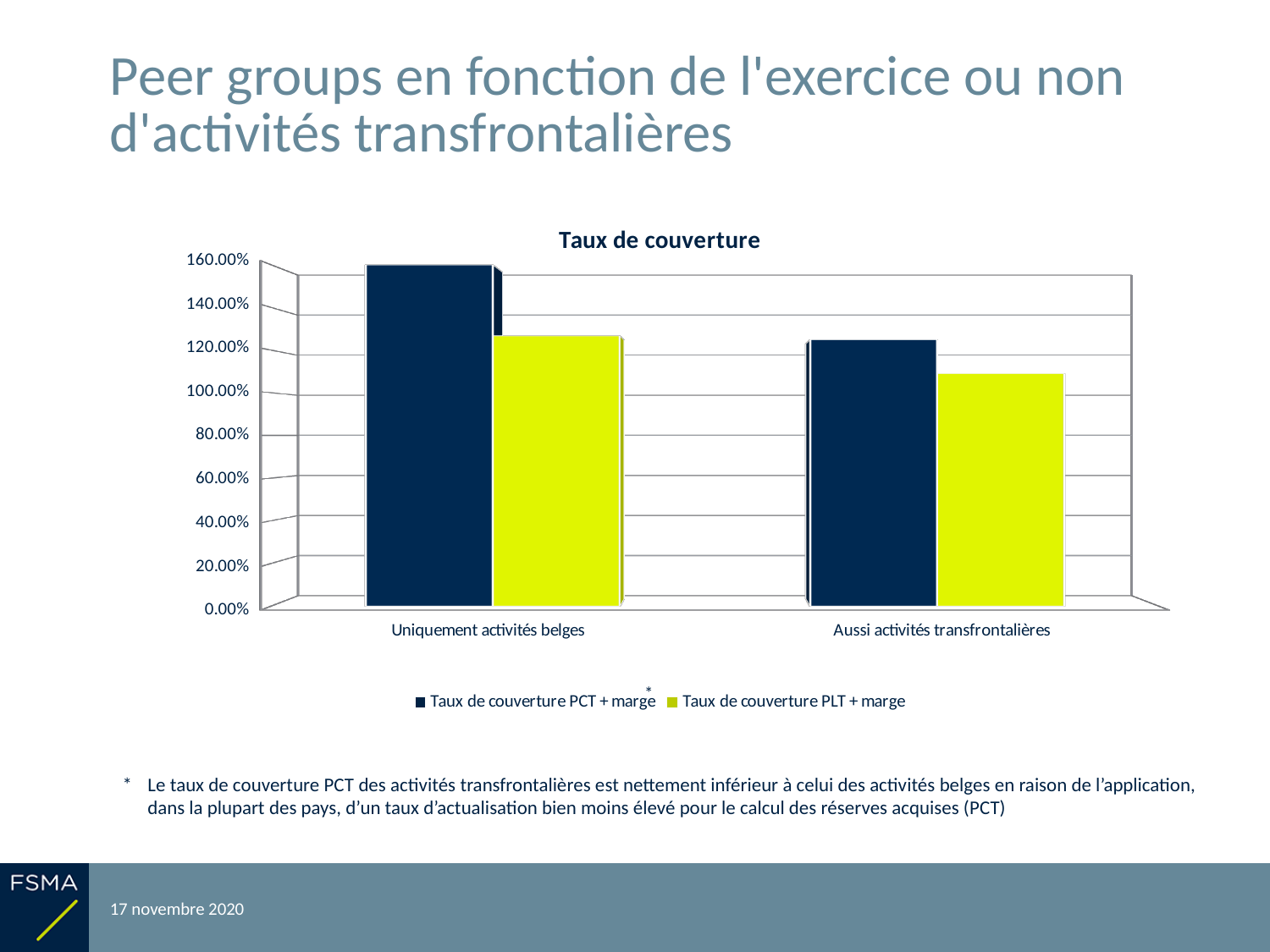
What is the title of the chart? Taux de couverture How many series does the chart's legend list? 2 Which category has the higher value for 'Taux de couverture PCT + marge': 'Uniquement activités belges' or 'Aussi activités transfrontalières'? Uniquement activités belges Is the value of 'Taux de couverture PCT + marge' for 'Aussi activités transfrontalières' greater or less than 140.00%? less Which bar in the chart is the shortest? Taux de couverture PLT + marge for Aussi activités transfrontalières For 'Aussi activités transfrontalières', which series has the larger value: 'Taux de couverture PCT + marge' or 'Taux de couverture PLT + marge'? Taux de couverture PCT + marge How many categories are shown on the x axis of the chart? 2 Is the value of 'Taux de couverture PLT + marge' for 'Aussi activités transfrontalières' greater or less than 120.00%? less Which bar in the chart is the tallest? Taux de couverture PCT + marge for Uniquement activités belges Is the value of 'Taux de couverture PLT + marge' for 'Uniquement activités belges' greater or less than 140.00%? less What kind of chart is shown on the slide? Bar chart